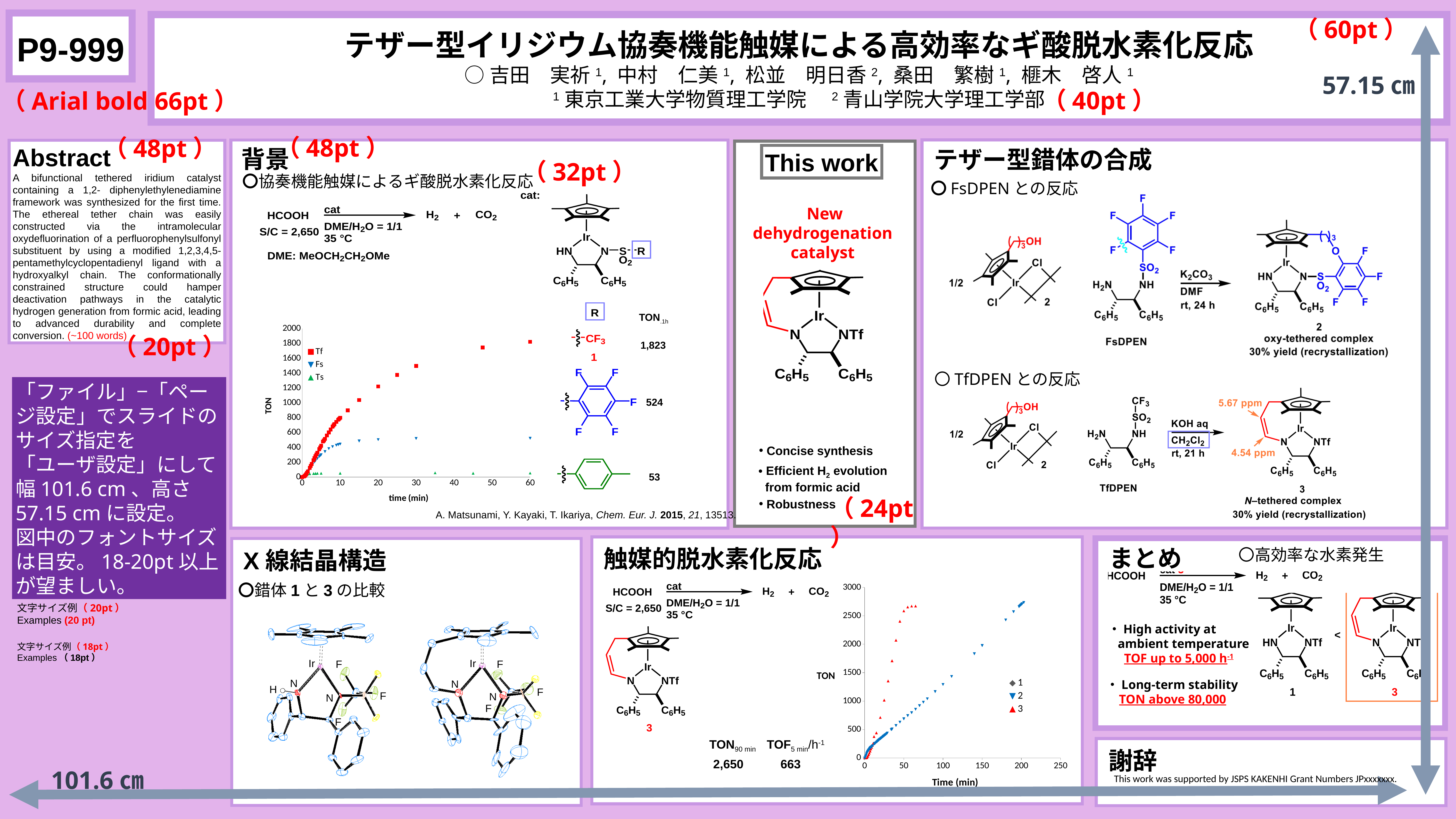
In the 触媒的脱水素化反応 chart (TON vs Time), which series reaches a TON above 2500 fastest? 3 In the 触媒的脱水素化反応 chart (TON vs Time), does the TON for series 2 rise or fall as time increases? rise In the 背景 chart (TON vs time), how many series does the legend list? 3 In the 背景 chart (TON vs time), what are the legend entries? Tf, Fs, Ts In the 触媒的脱水素化反応 chart (TON vs Time), is the TON for series 2 at 100 min greater or less than 2000? less In the 背景 chart (TON vs time), what is the label of the x axis? time (min) In the 背景 chart (TON vs time), is the TON for Fs at 60 min greater or less than 1000? less In the 触媒的脱水素化反応 chart (TON vs Time), how many series does the legend list? 3 In the 背景 chart (TON vs time), which series has the lowest TON? Ts In the 背景 chart (TON vs time), is the TON for Tf at 60 min greater or less than 1600? greater In the 背景 chart (TON vs time), which series reaches the highest TON? Tf